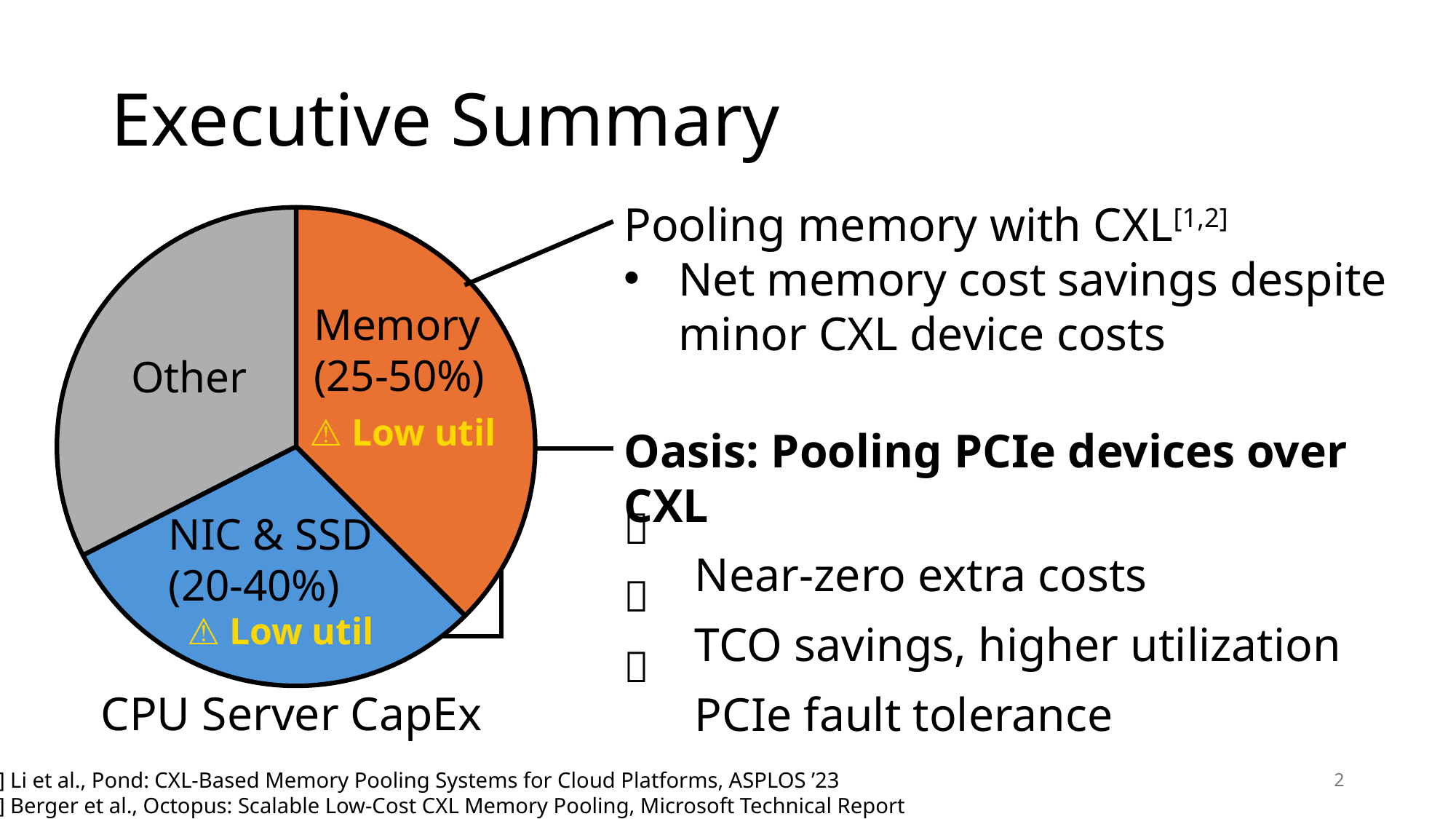
What percentage range is shown for the Memory slice of the CPU Server CapEx pie chart? 25-50% In the CPU Server CapEx pie chart, which slice is larger: Memory or NIC & SSD? Memory Which slice of the CPU Server CapEx pie chart is the largest? Memory How many slices does the CPU Server CapEx pie chart have? 3 What percentage range is shown for the NIC & SSD slice of the CPU Server CapEx pie chart? 20-40% Which slice of the CPU Server CapEx pie chart has no percentage range printed? Other Which slices of the CPU Server CapEx pie chart are marked with a 'Low util' warning? Memory and NIC & SSD What colour is the NIC & SSD slice in the CPU Server CapEx pie chart? blue What is the title of the pie chart? CPU Server CapEx What kind of chart is shown on the slide? pie chart